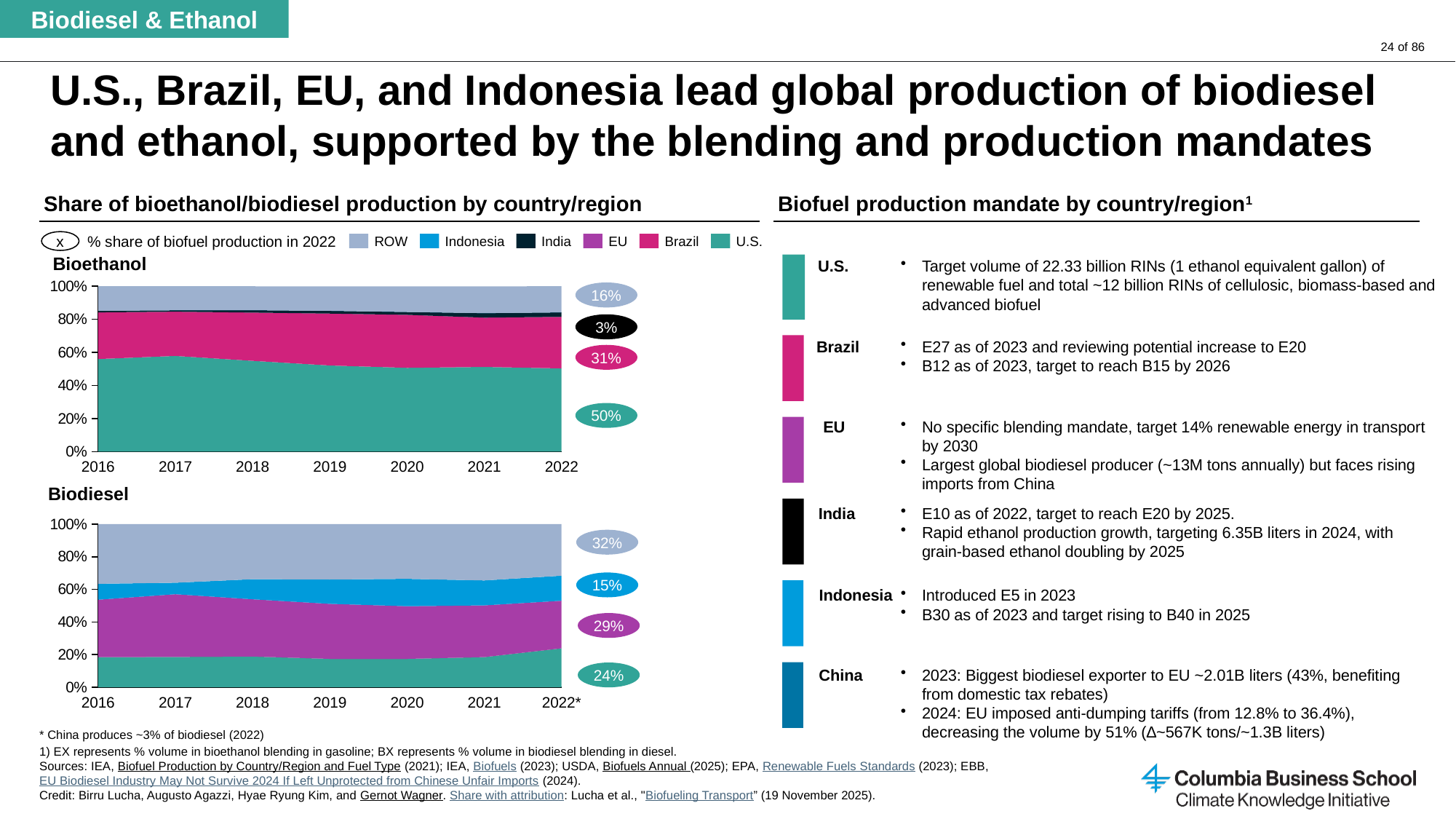
In the Bioethanol chart, what is the difference between the U.S. share and Brazil's share in 2022? 19 percentage points In the Bioethanol chart, is the U.S. share in 2016 greater or less than 40%? greater How many series does the legend list for the share of bioethanol/biodiesel production charts? 6 In the Bioethanol chart, which country/region has the largest share of production in 2022? U.S. In the Biodiesel chart, which is larger in 2022: the EU share or the U.S. share? EU How many years are shown on the x axis of the Biodiesel chart? 7 In the Biodiesel chart, what is the EU's share of biodiesel production in 2022? 29% In the Biodiesel chart, what is Indonesia's share of biodiesel production in 2022? 15% What type of chart is used to show the share of bioethanol production by country/region? Stacked area chart In the Bioethanol chart, what is the U.S. share of bioethanol production in 2022? 50% In the Biodiesel chart, which labelled country/region has the smallest share of production in 2022? Indonesia In the Bioethanol chart, what is Brazil's share of bioethanol production in 2022? 31%